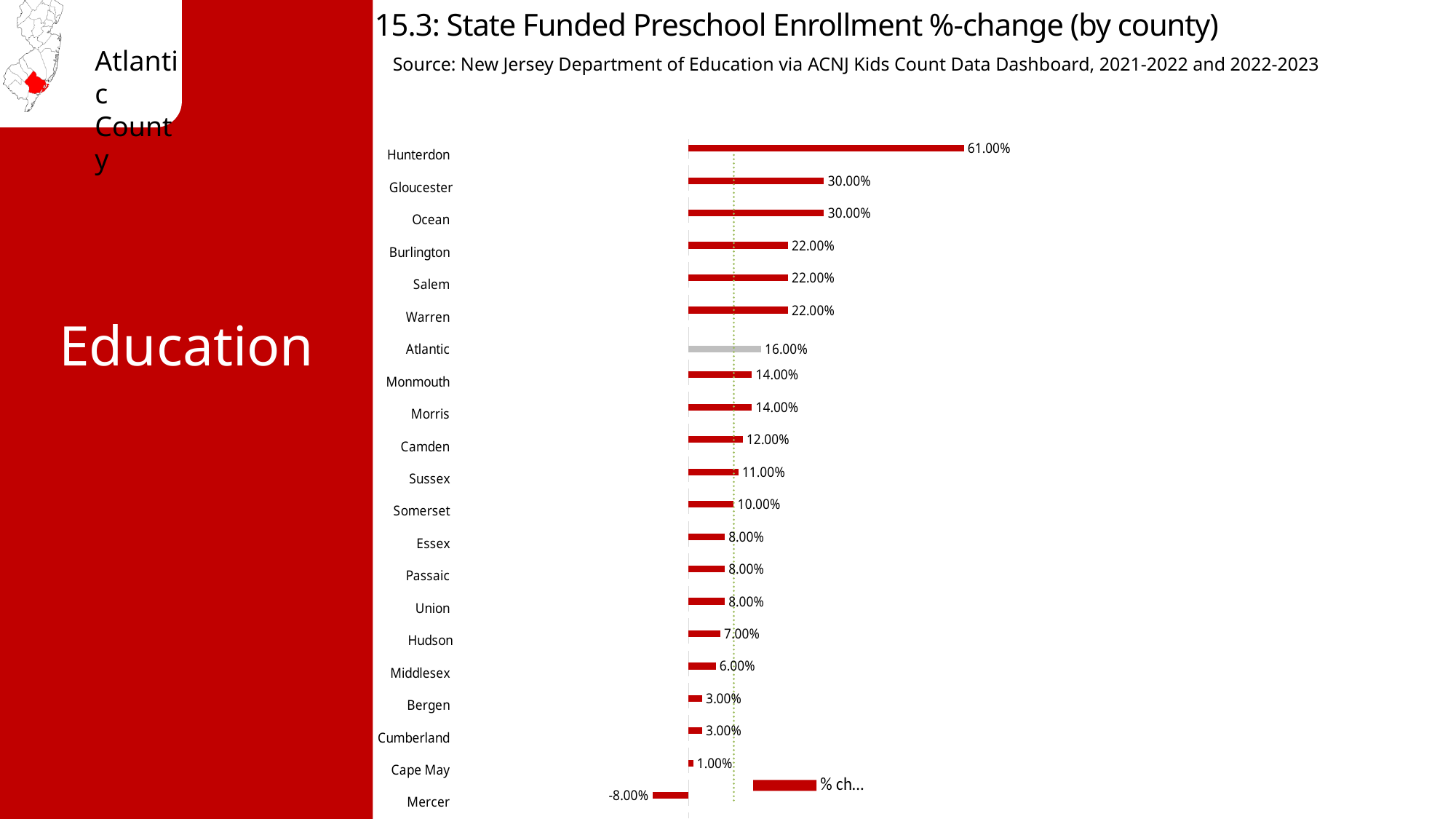
What is the difference between the values for Hunterdon and Gloucester? 31.00% Which county has the lowest %-change? Mercer What is the state funded preschool enrollment %-change for Hunterdon? 61.00% Which county's bar is coloured grey instead of red? Atlantic Which county has the highest %-change? Hunterdon What is the value shown for Cape May? 1.00% What is the difference between the values for Atlantic and Camden? 4.00% What is the value shown for Mercer? -8.00% What is the value shown for Atlantic County? 16.00% How many counties are shown in the chart? 21 Which is larger, the value for Burlington or the value for Monmouth? Burlington What kind of chart is shown on the slide? Bar chart